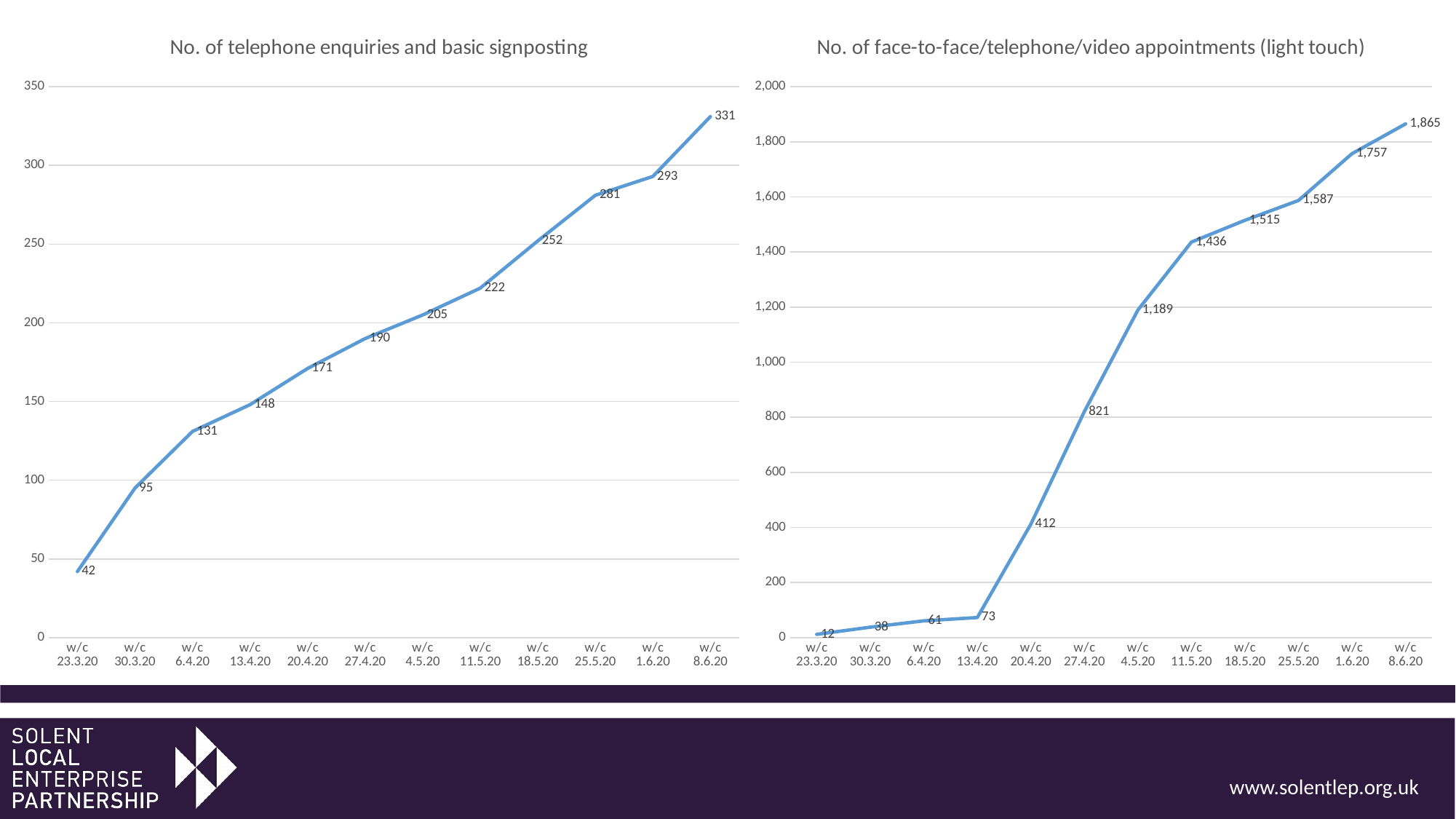
What is the title of the chart on the right of the slide? No. of face-to-face/telephone/video appointments (light touch) In the 'No. of telephone enquiries and basic signposting' chart, which week has the highest value? w/c 8.6.20 In the 'No. of telephone enquiries and basic signposting' chart, do the values rise or fall from w/c 23.3.20 to w/c 8.6.20? Rise In the 'No. of telephone enquiries and basic signposting' chart, is the value for w/c 25.5.20 greater or less than 250? greater In the 'No. of face-to-face/telephone/video appointments (light touch)' chart, what is the difference between the values for w/c 20.4.20 and w/c 13.4.20? 339 What kind of chart is the 'No. of face-to-face/telephone/video appointments (light touch)' chart? Line chart In the 'No. of face-to-face/telephone/video appointments (light touch)' chart, what is the value for w/c 27.4.20? 821 In the 'No. of face-to-face/telephone/video appointments (light touch)' chart, which is larger: the value for w/c 4.5.20 or w/c 11.5.20? w/c 11.5.20 In the 'No. of telephone enquiries and basic signposting' chart, what is the value for w/c 13.4.20? 148 How many weeks are plotted in the 'No. of telephone enquiries and basic signposting' chart? 12 In the 'No. of face-to-face/telephone/video appointments (light touch)' chart, which week has the lowest value? w/c 23.3.20 In the 'No. of telephone enquiries and basic signposting' chart, what is the difference between the values for w/c 8.6.20 and w/c 1.6.20? 38